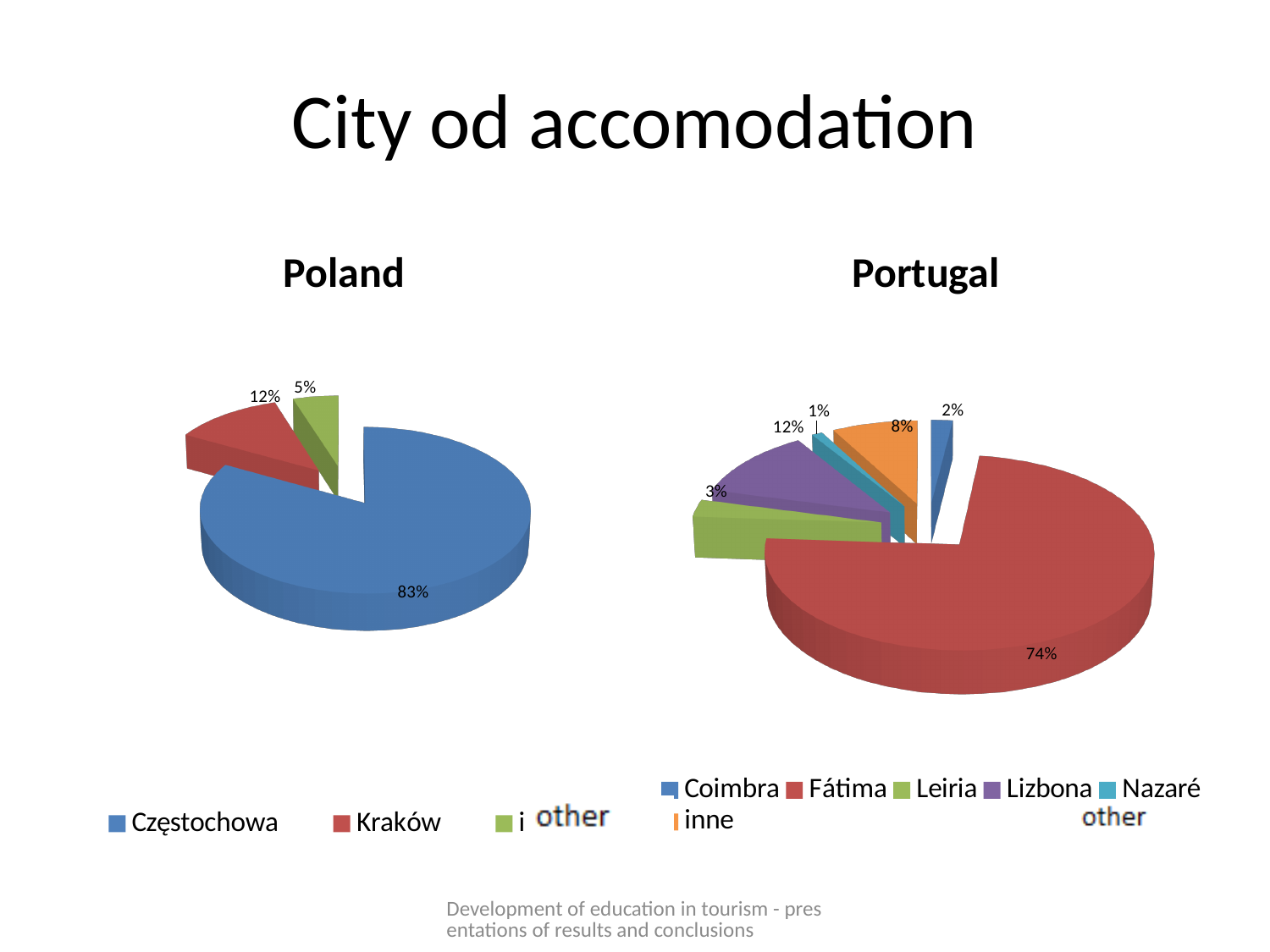
In the Poland chart, which category has the largest share? Częstochowa In the Poland chart, what percentage is shown for Kraków? 12% In the Portugal chart, what percentage is shown for Leiria? 3% How many slices does the Poland chart have? 3 In the Portugal chart, which is larger, the share for Coimbra or the share for Leiria? Leiria In the Portugal chart, what share is shown for Fátima? 74% In the Portugal chart, which city has the smallest share? Nazaré What type of chart is used for Poland and Portugal on this slide? Pie chart In the Poland chart, what is the difference in percentage points between Częstochowa and Kraków? 71 In the Portugal chart, what percentage is shown for Lizbona? 12% How many categories does the legend of the Portugal chart list? 6 In the Poland chart, what share of accommodation is in Częstochowa? 83%